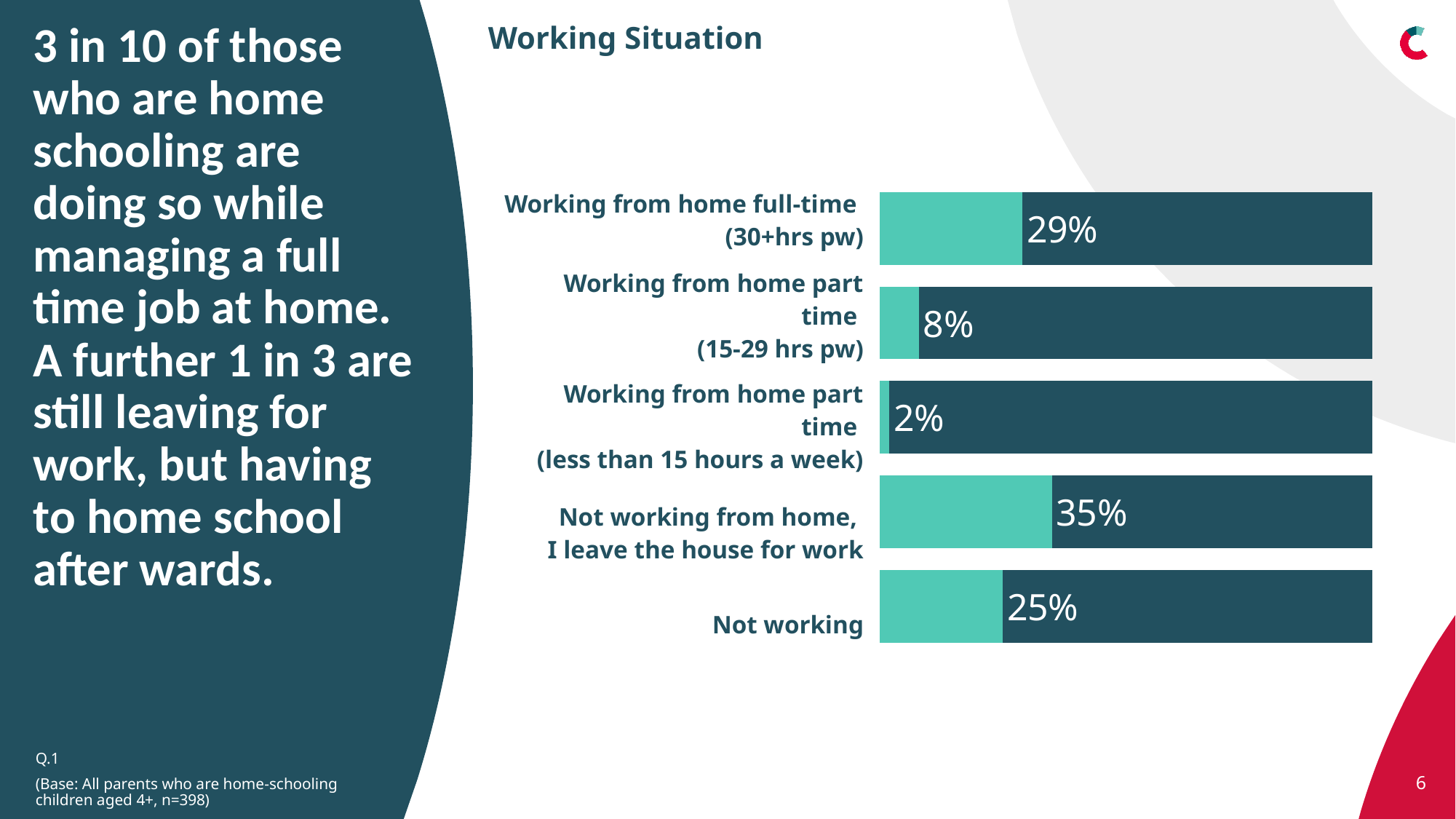
Which working situation has the lowest percentage? Working from home part time (less than 15 hours a week) Which working situation has the highest percentage? Not working from home, I leave the house for work What percentage of respondents are working from home part time (less than 15 hours a week)? 2% What percentage of respondents are working from home full-time (30+hrs pw)? 29% What type of chart is used to show the working situation data? Bar chart What is the title of the chart? Working Situation What percentage of respondents are not working? 25% How many working situation categories are shown in the chart? 5 What is the difference in percentage points between those not working from home who leave the house for work and those working from home full-time? 6 What percentage of respondents are working from home part time (15-29 hrs pw)? 8% What percentage of respondents are not working from home and leave the house for work? 35% Which is larger: the percentage not working or the percentage working from home full-time (30+hrs pw)? Working from home full-time (30+hrs pw)